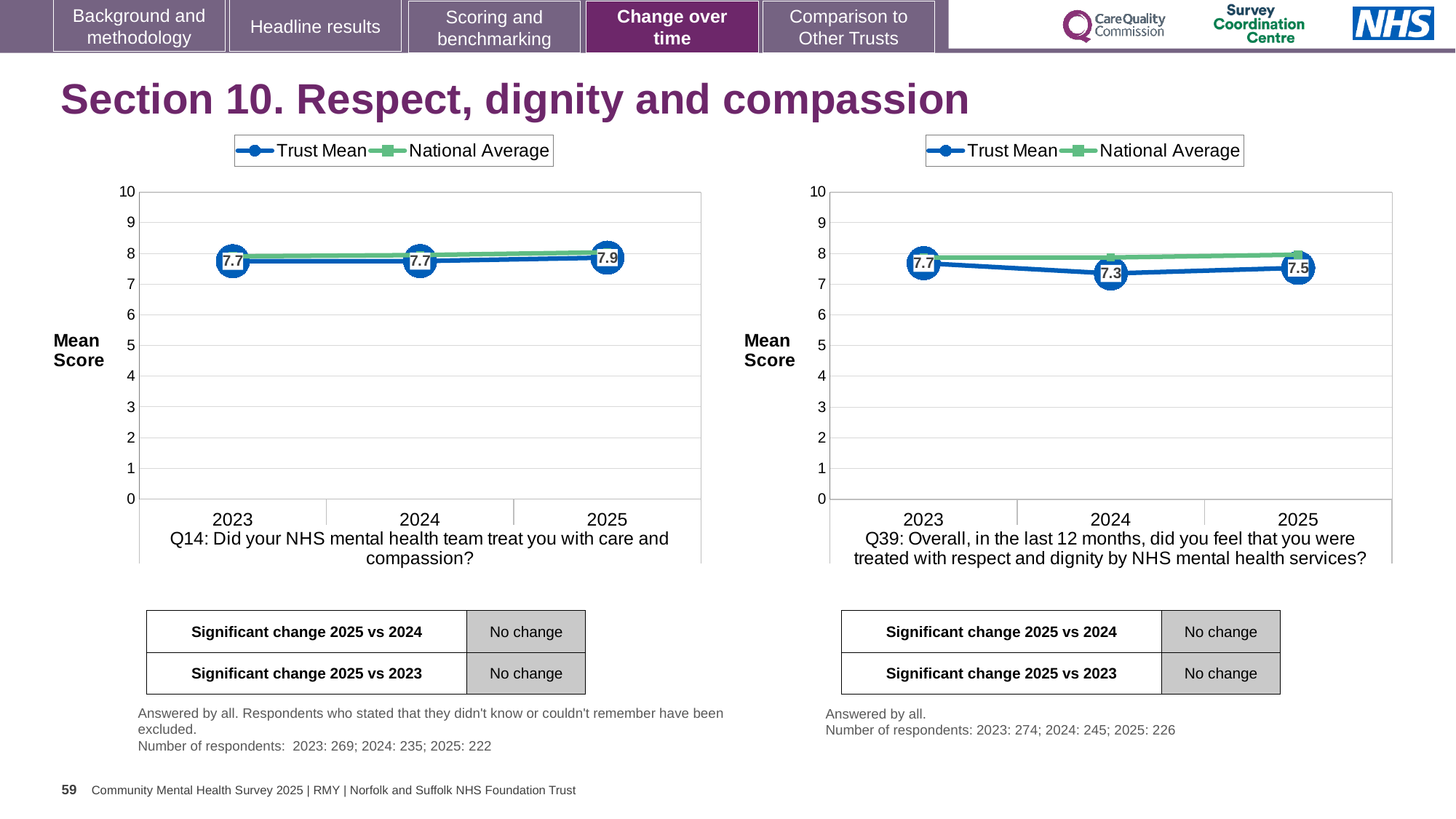
In the Q39 chart (right), what is the Trust Mean for 2024? 7.3 In the Q14 chart (left), what is the Trust Mean for 2023? 7.7 In the Q39 chart (right), what is the difference between the Trust Mean for 2023 and 2024? 0.4 In the Q39 chart (right), which year has the lowest Trust Mean? 2024 Is the Trust Mean for 2025 larger in the Q14 chart (left) or the Q39 chart (right)? Q14 chart (left) In the Q14 chart (left), what is the difference between the Trust Mean for 2025 and 2024? 0.2 In the Q39 chart (right), what is the Trust Mean for 2025? 7.5 How many series does the legend of the Q14 chart (left) list? 2 In the Q14 chart (left), what is the Trust Mean for 2025? 7.9 In the Q14 chart (left), which year has the highest Trust Mean? 2025 In the Q39 chart (right), is the National Average for 2024 greater or less than 7? greater What kind of chart is the Q39 chart (right)? line chart